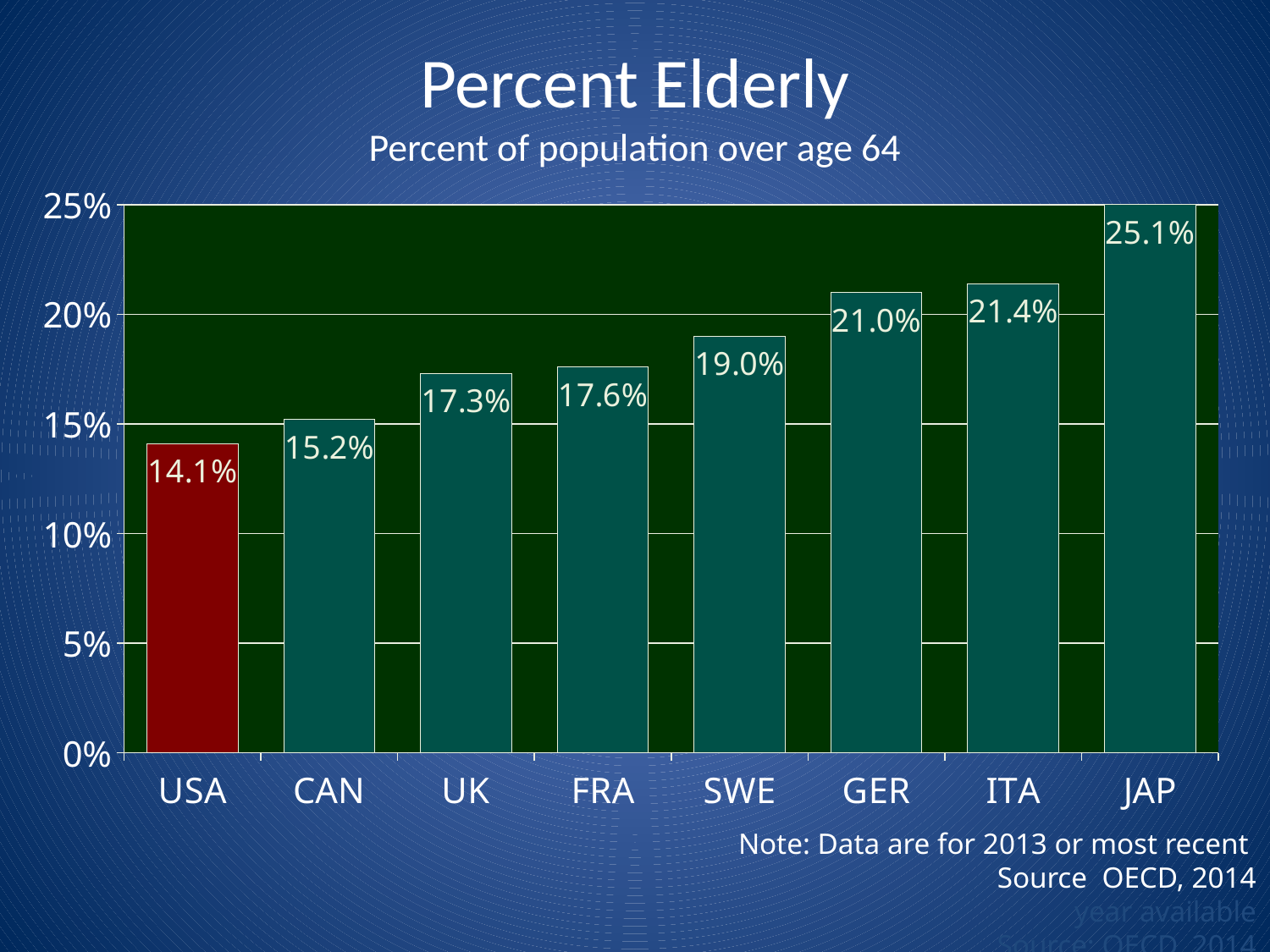
Do the values rise or fall from left to right across the x axis? Rise What is the difference in percent elderly between Italy (ITA) and Germany (GER)? 0.4% What is the percent elderly value for the USA? 14.1% Which has a higher percent elderly, Canada (CAN) or the UK? UK What is the percent elderly value for Germany (GER)? 21.0% Which country has the lowest percent elderly? USA Which country has the highest percent elderly? JAP How many countries are shown in the chart? 8 What is the difference in percent elderly between Japan (JAP) and the USA? 11.0% What is the percent elderly value for Sweden (SWE)? 19.0% Is the value for France (FRA) greater or less than 15%? greater What kind of chart is shown on the slide? Bar chart